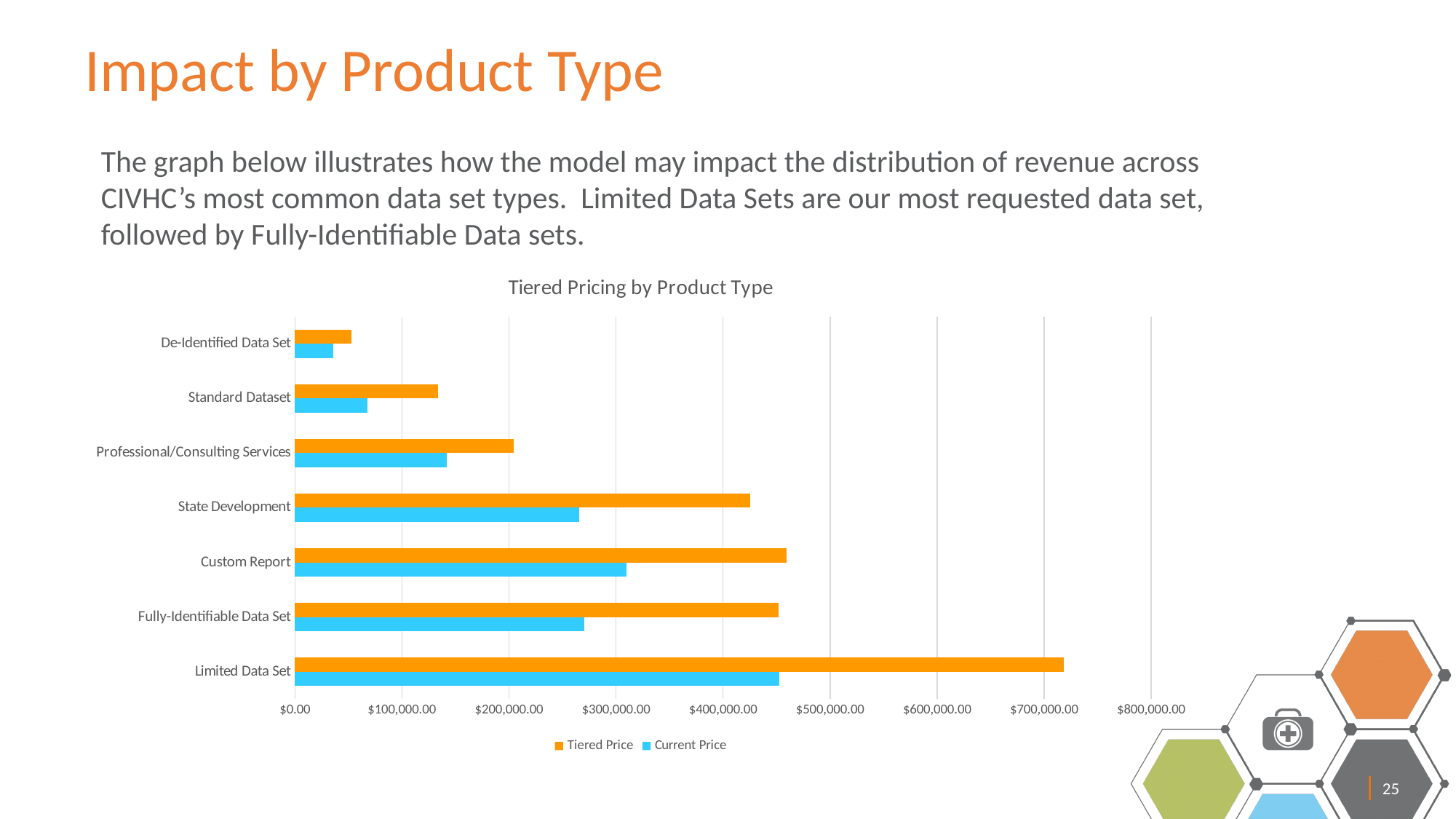
How many series does the chart's legend list? 2 Which colour represents the Current Price series in the chart? blue Which product type has the highest Tiered Price? Limited Data Set What is the title of the chart? Tiered Pricing by Product Type For Fully-Identifiable Data Set, which is larger, the Tiered Price or the Current Price? Tiered Price Is the Current Price for Limited Data Set greater or less than $500,000.00? less Which product type has the lowest Tiered Price? De-Identified Data Set Is the Tiered Price for Limited Data Set greater or less than $700,000.00? greater How many product type categories are shown on the chart? 7 What kind of chart is shown on the slide? bar chart Which product type has the highest Current Price? Limited Data Set Is the Tiered Price for State Development greater or less than $400,000.00? greater